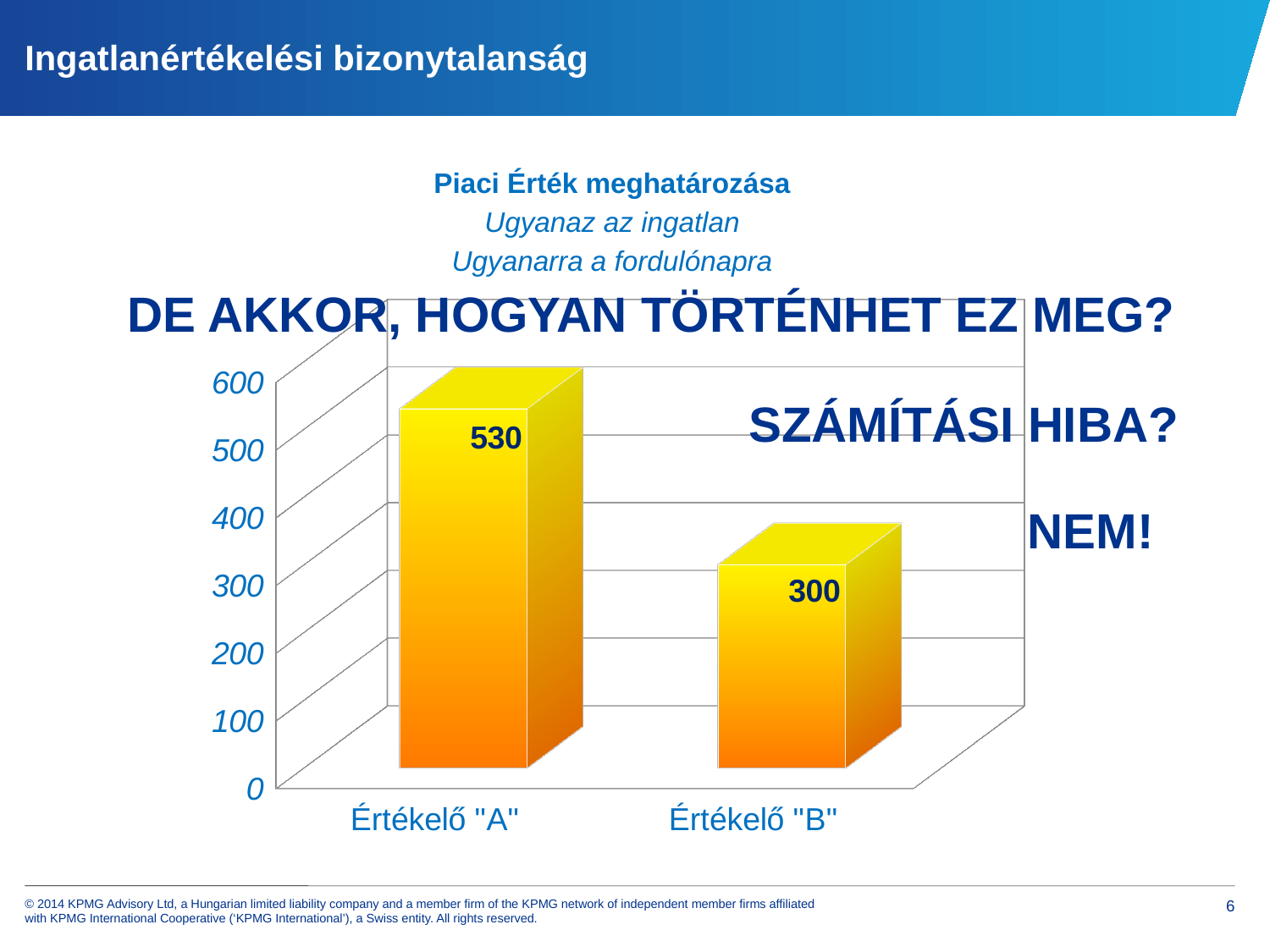
What is the value for Értékelő "A"? 530 What kind of chart is shown on the slide? bar chart What is the highest tick value shown on the vertical axis of the chart? 600 Which category has the lowest value? Értékelő "B" Which category has the highest value? Értékelő "A" What is the value for Értékelő "B"? 300 Which is larger, the value for Értékelő "A" or Értékelő "B"? Értékelő "A" Is the value for Értékelő "B" greater or less than 400? less Is the value for Értékelő "A" greater or less than 500? greater Do the values rise or fall from Értékelő "A" to Értékelő "B"? fall What is the difference between the values for Értékelő "A" and Értékelő "B"? 230 How many categories are shown on the x axis of the chart? 2